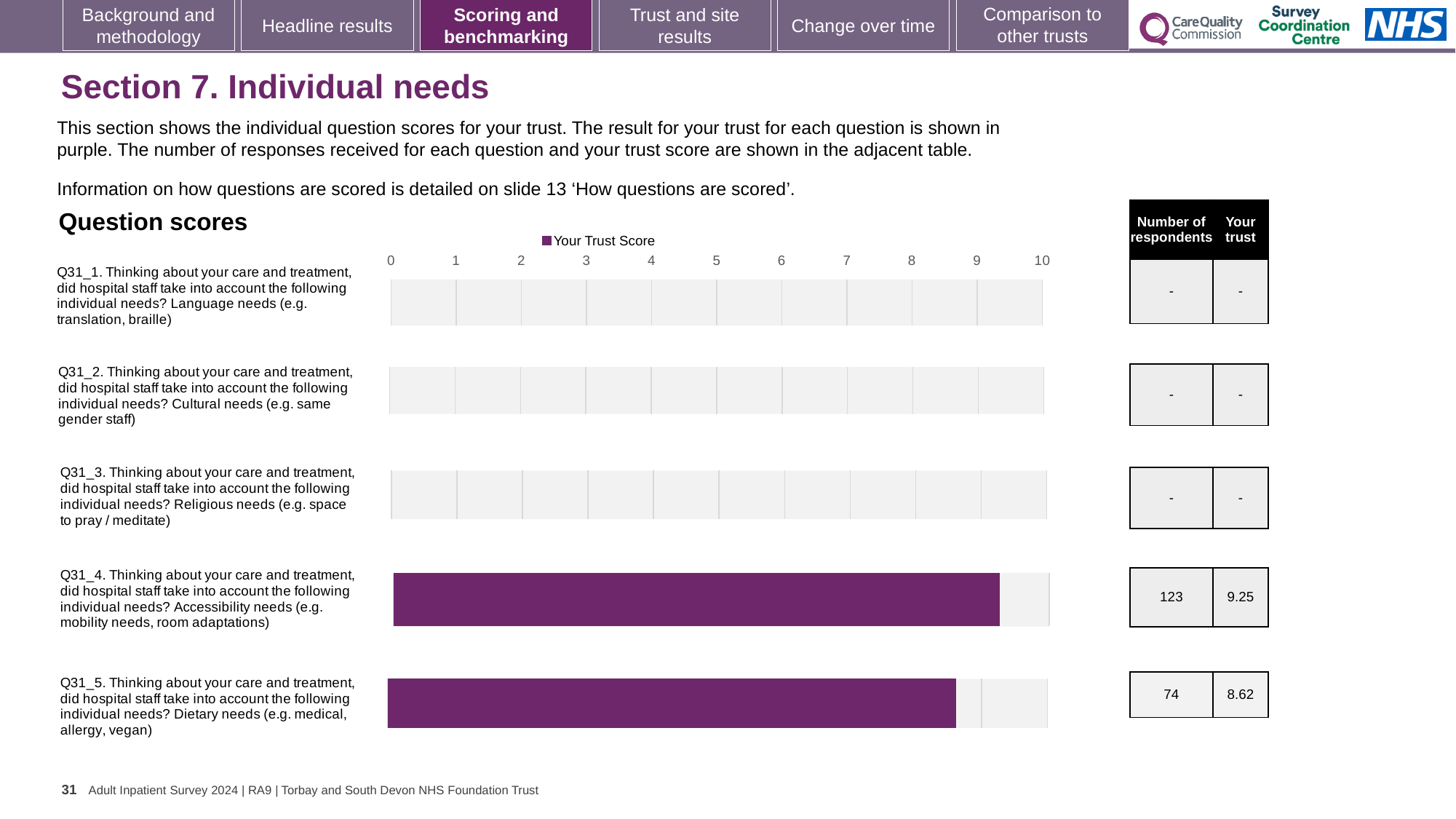
How many questions are listed in the Question scores chart? 5 Is the trust score for Q31_5 (Dietary needs) greater or less than 9? less Which has the larger trust score, Q31_4 (Accessibility needs) or Q31_5 (Dietary needs)? Q31_4 (Accessibility needs) How many series does the chart legend list? 1 What kind of chart is used to show the question scores? Bar chart How many respondents answered Q31_4 (Accessibility needs)? 123 Which question has the highest trust score shown on the slide? Q31_4 (Accessibility needs) How many respondents answered Q31_5 (Dietary needs)? 74 Is the trust score for Q31_4 (Accessibility needs) greater or less than 9? greater What is the difference between the trust scores for Q31_4 and Q31_5? 0.63 What is the trust score for Q31_4 (Accessibility needs)? 9.25 What is the trust score for Q31_5 (Dietary needs)? 8.62